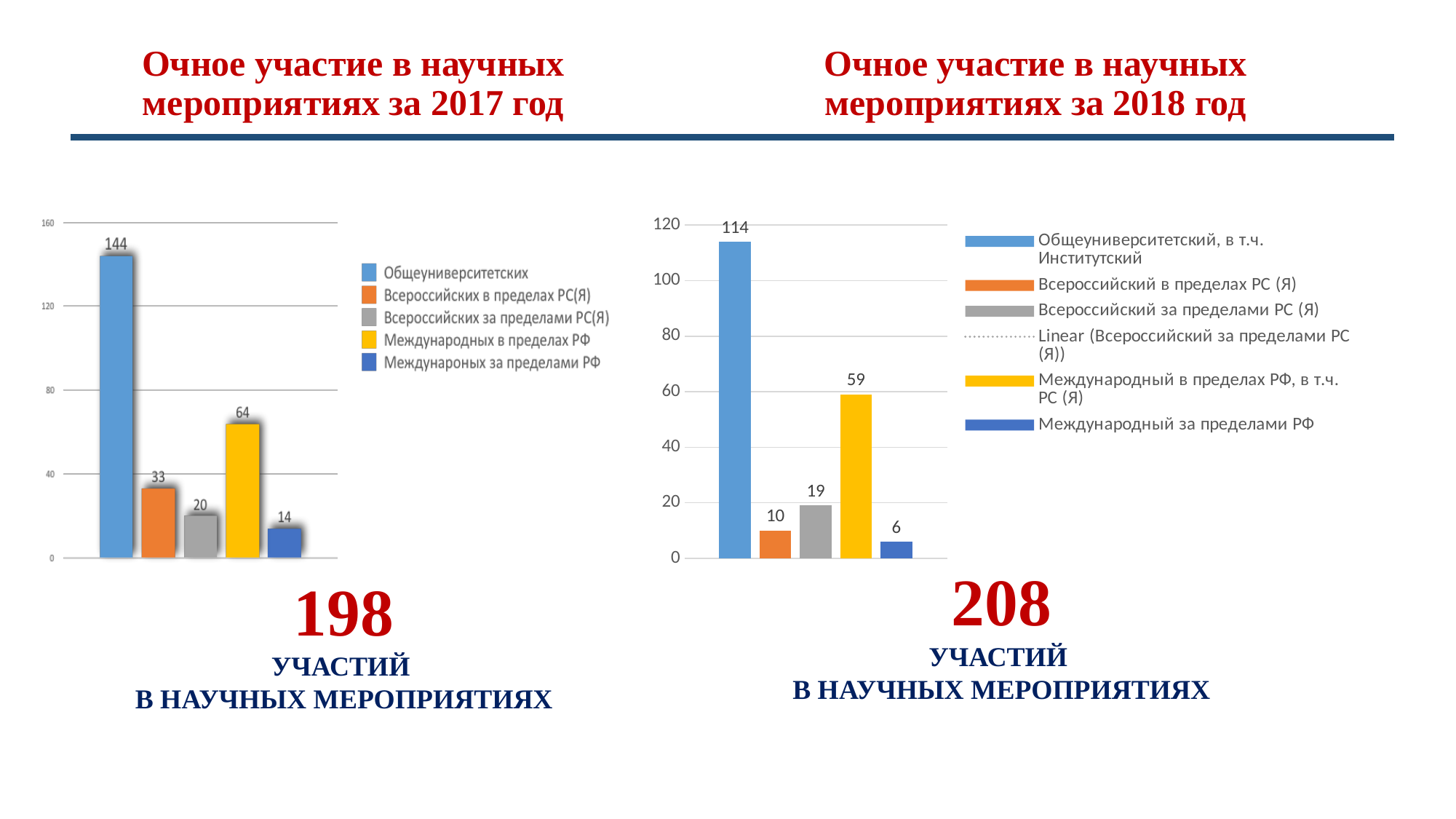
In the 2017 chart (left), what is the value for Общеуниверситетских? 144 What type of chart is the 2018 chart (right)? Bar chart In the 2018 chart (right), what is the value for Международный за пределами РФ? 6 In the 2018 chart (right), what is the difference between Всероссийский за пределами РС (Я) and Всероссийский в пределах РС (Я)? 9 In the 2018 chart (right), which is larger: Международный в пределах РФ, в т.ч. РС (Я) or Всероссийский за пределами РС (Я)? Международный в пределах РФ, в т.ч. РС (Я) How many bars are plotted in the 2017 chart (left)? 5 In the 2018 chart (right), which category has the highest value? Общеуниверситетский, в т.ч. Институтский In the 2017 chart (left), what is the difference between Общеуниверситетских and Международных в пределах РФ? 80 In the 2018 chart (right), what is the value for Всероссийский в пределах РС (Я)? 10 How many entries does the legend of the 2018 chart (right) list? 6 In the 2017 chart (left), which category has the lowest value? Междунароных за пределами РФ In the 2017 chart (left), what is the value for Международных в пределах РФ? 64